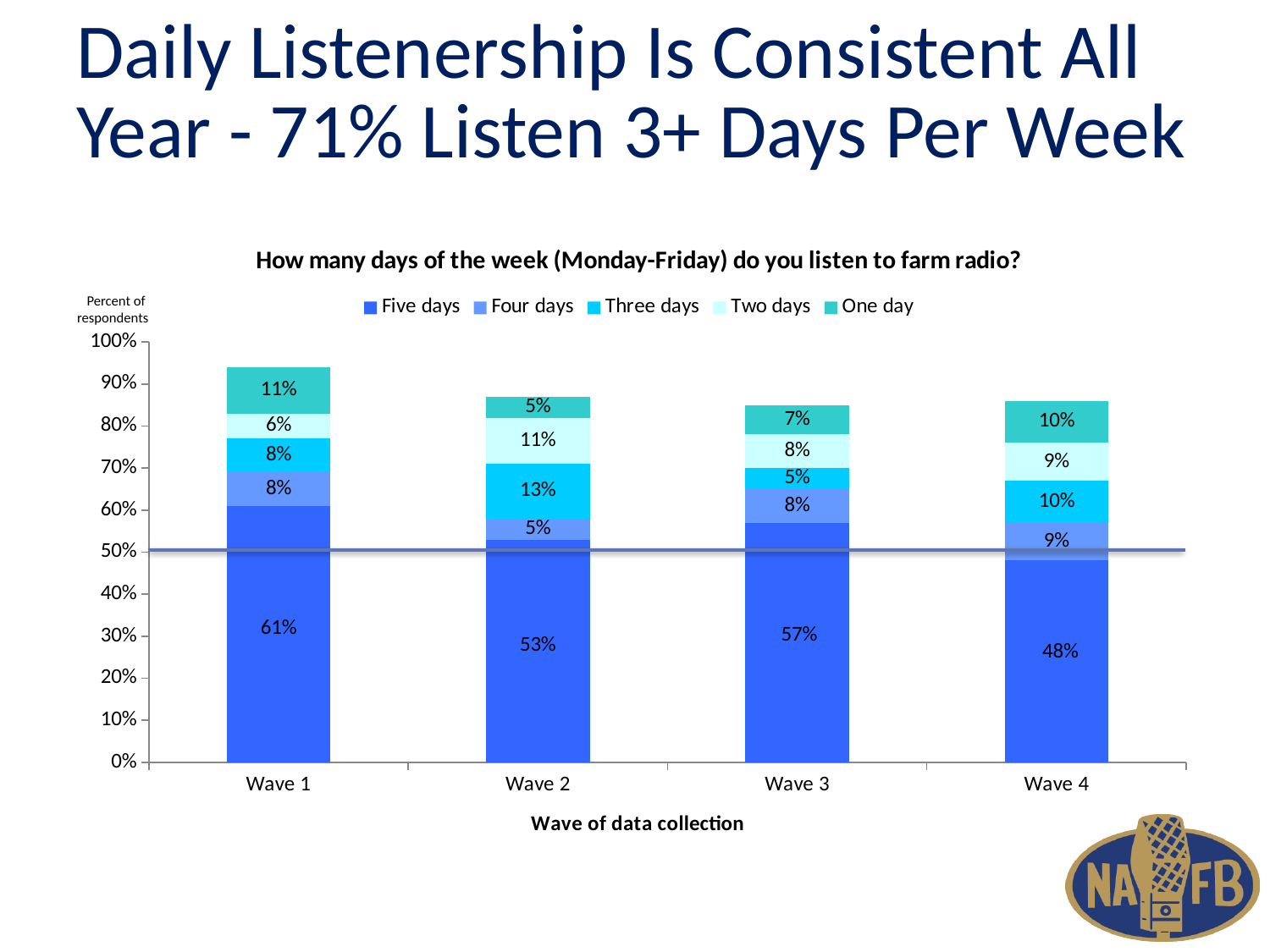
What is the value for 'Two days' in Wave 3? 8% Which wave has the lowest value for 'Five days'? Wave 4 Which wave has the highest value for 'Five days'? Wave 1 What is the value for 'Three days' in Wave 2? 13% Which is larger, the 'Three days' value in Wave 2 or the 'Three days' value in Wave 3? Wave 2 What is the difference between the 'Five days' values for Wave 1 and Wave 4? 13 percentage points What is the value for 'One day' in Wave 4? 10% What percentage of respondents in Wave 1 listen to farm radio five days a week? 61% How many series does the legend list? 5 What is the total of the stacked bar for Wave 1? 94% What kind of chart is shown on the slide? Stacked bar chart How many waves of data collection are shown on the x axis? 4